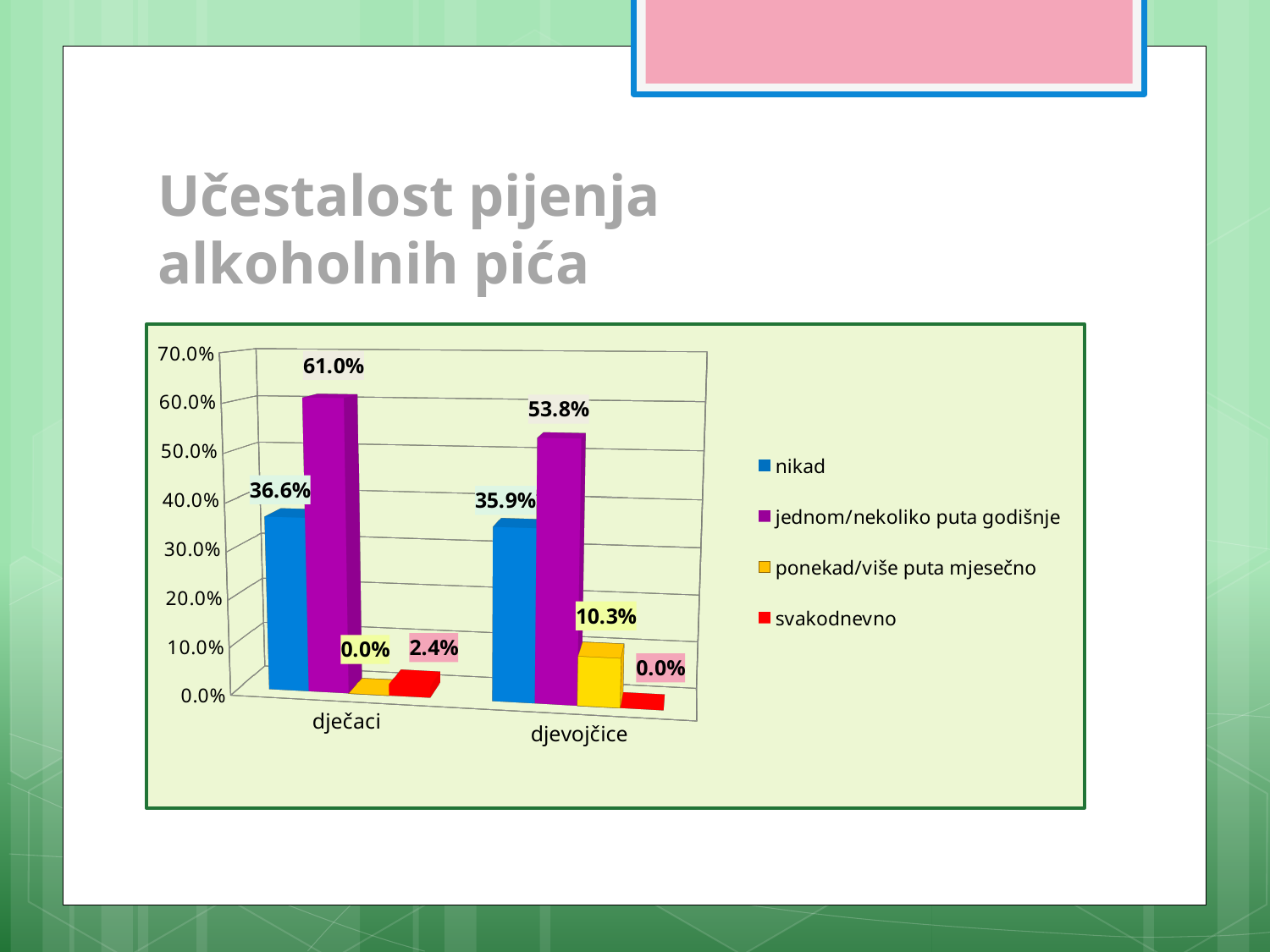
What is the value for 'nikad' for djevojčice? 35.9% Which series has the highest value for dječaci? jednom/nekoliko puta godišnje What kind of chart is shown on the slide? bar chart What is the value for 'svakodnevno' for dječaci? 2.4% How many categories are shown on the x axis? 2 How many series does the legend list? 4 Which is larger: the 'nikad' value for dječaci or for djevojčice? dječaci What is the difference between the 'jednom/nekoliko puta godišnje' values for dječaci and djevojčice? 7.2% What colour represents the 'svakodnevno' series? red Which series has the lowest value for djevojčice? svakodnevno What is the value for 'ponekad/više puta mjesečno' for djevojčice? 10.3% What is the value for 'jednom/nekoliko puta godišnje' for dječaci? 61.0%